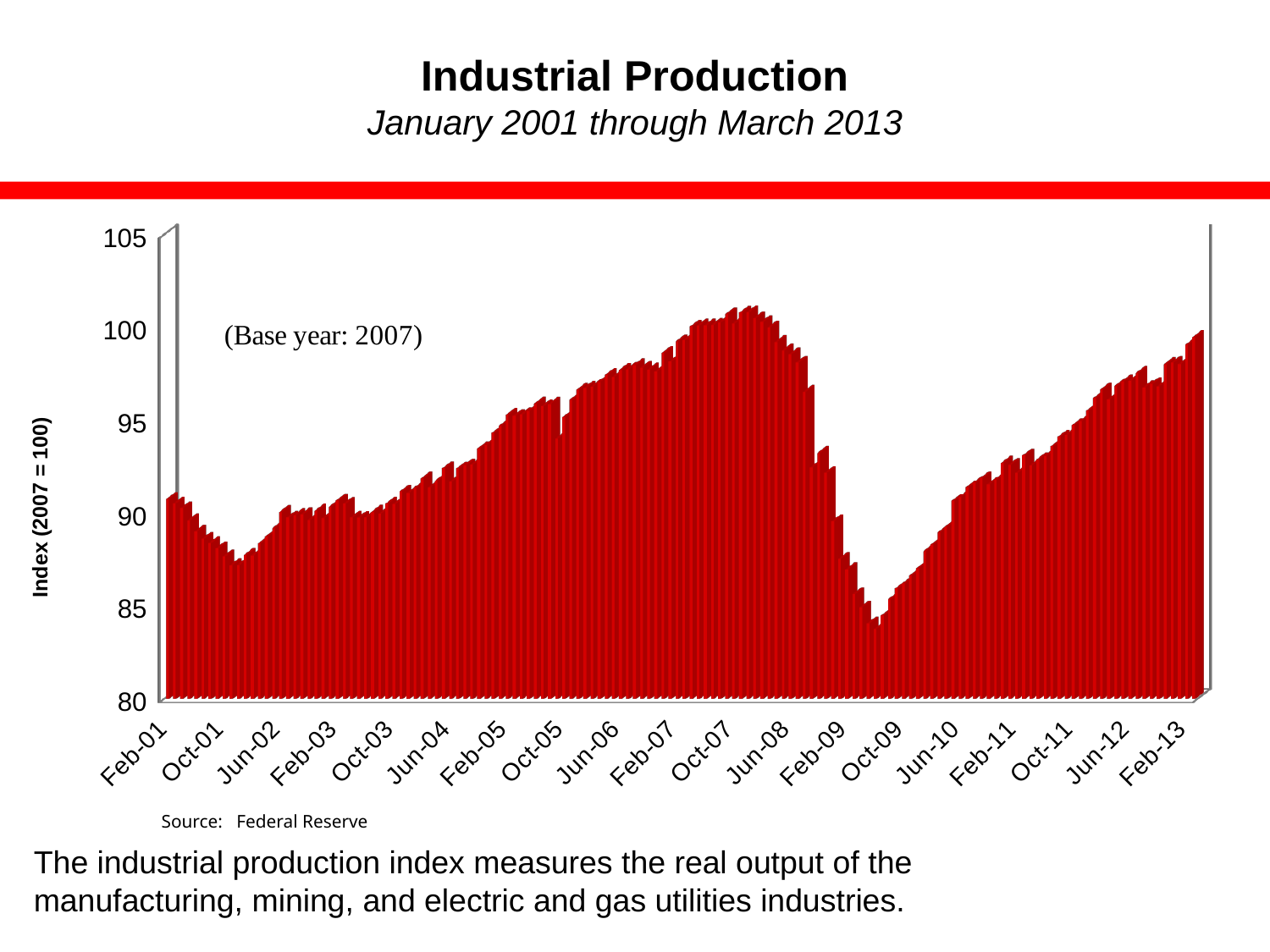
Do the values rise or fall between Oct-07 and Oct-09? fall Is the value for Feb-09 greater or less than 95? less Is the value for Feb-01 greater or less than 90? greater What kind of chart is shown on the slide? Bar chart Which is larger, the value for Oct-07 or the value for Oct-09? Oct-07 Do the values rise or fall between Oct-09 and Feb-13? rise What is the title of the chart? Industrial Production Is the value for Oct-09 greater or less than 90? less What is the label on the vertical axis of the chart? Index (2007 = 100)